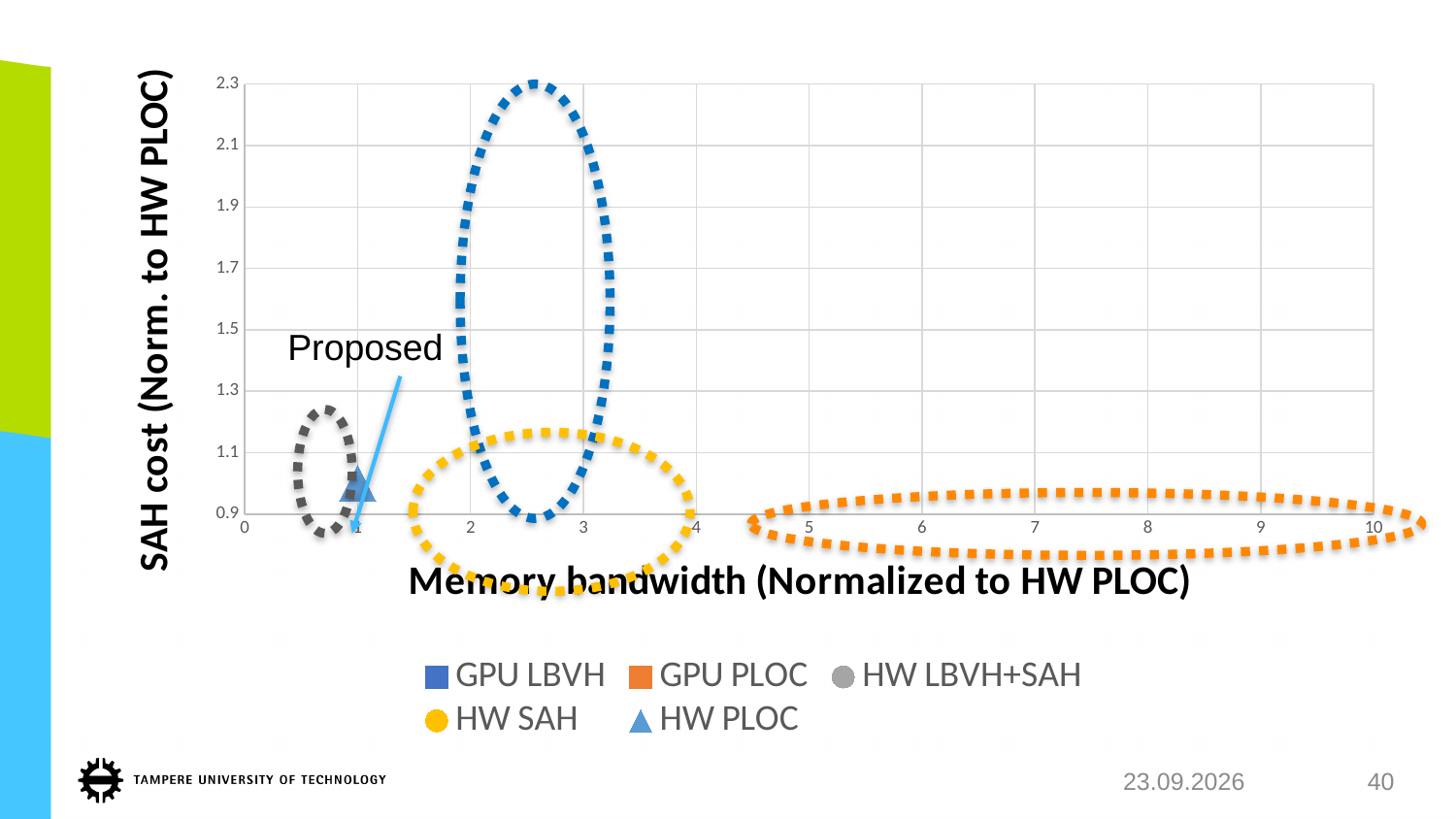
Is the SAH cost value for the HW PLOC point greater or less than 1.3? less What is the title of the y axis? SAH cost (Norm. to HW PLOC) What kind of chart is shown on the slide? scatter chart How many series does the legend list? 5 What is the highest value shown on the x axis? 10 What is the title of the x axis? Memory bandwidth (Normalized to HW PLOC) Is the memory bandwidth value for the HW PLOC point greater or less than 2? less What is the lowest value shown on the y axis? 0.9 What is the highest value shown on the y axis? 2.3